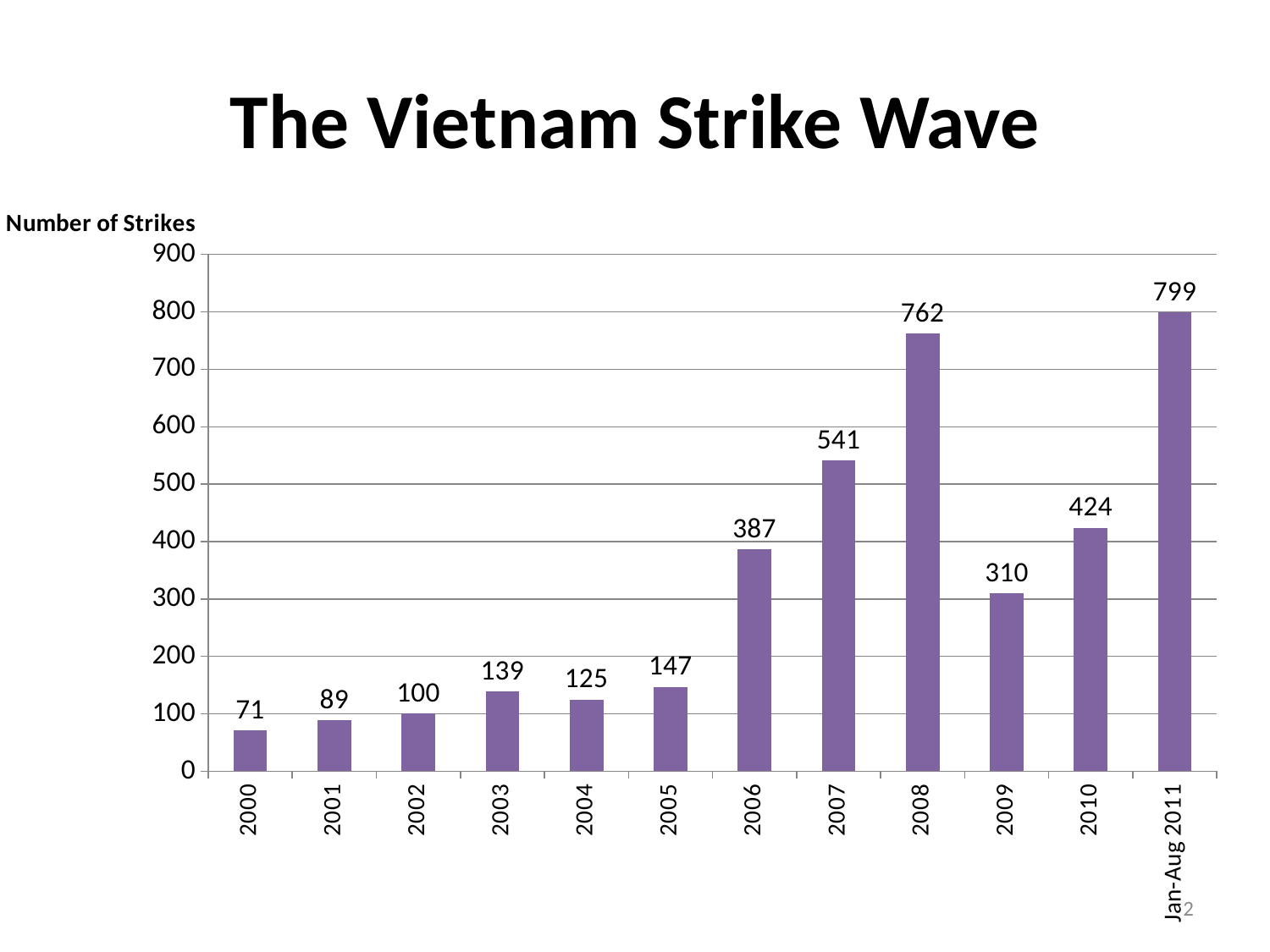
What is the difference in the number of strikes between 2008 and 2009? 452 How many periods are shown on the x axis? 12 What is the difference in the number of strikes between 2007 and 2006? 154 Is the number of strikes in 2010 greater or less than 400? greater What kind of chart is shown on the slide? bar chart What is the number of strikes in 2003? 139 What is the number of strikes for Jan-Aug 2011? 799 What is the label of the y axis? Number of Strikes Which year has the lowest number of strikes? 2000 What is the number of strikes in 2008? 762 Which year had more strikes, 2004 or 2005? 2005 Which period has the highest number of strikes? Jan-Aug 2011